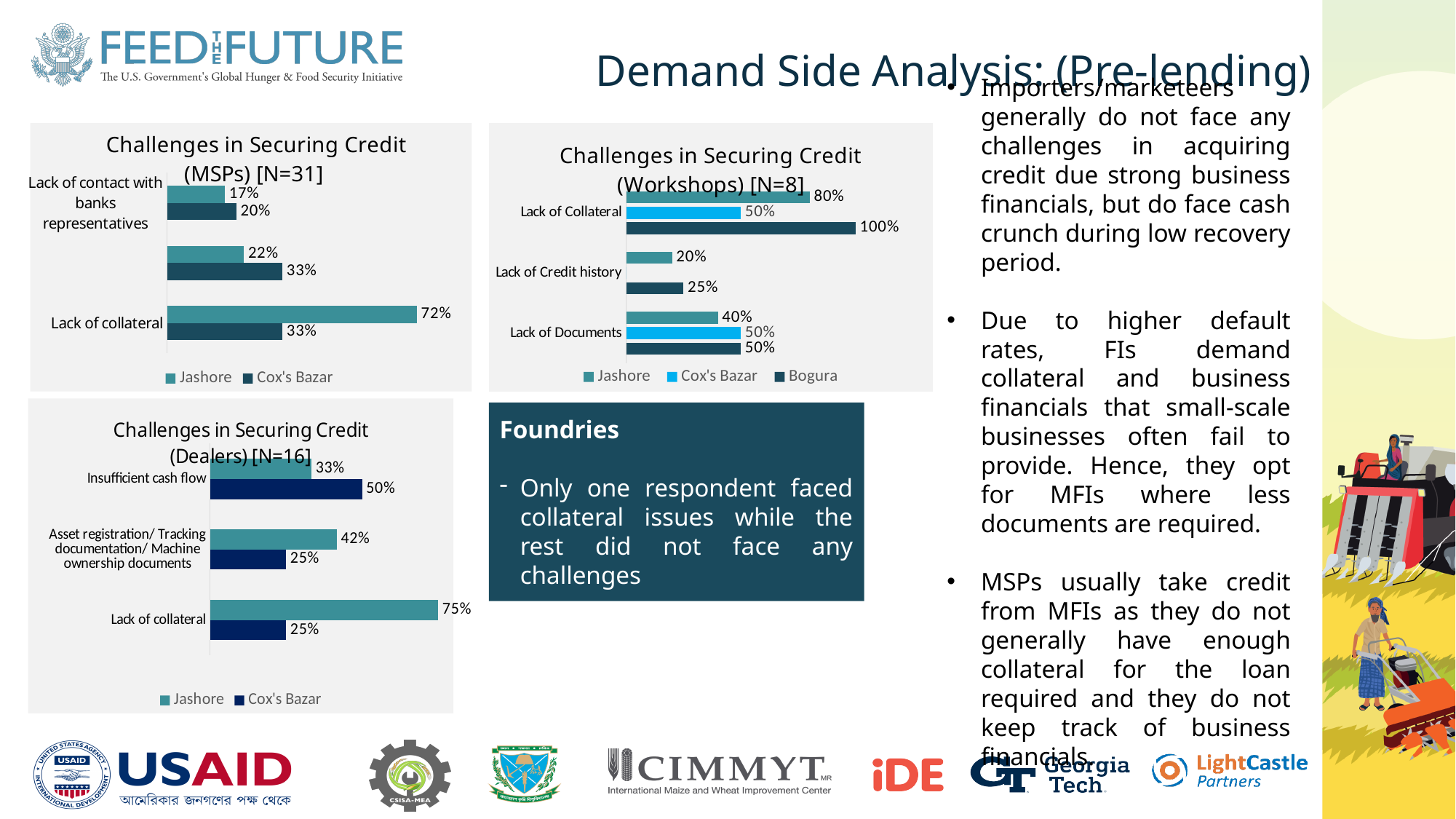
What kind of chart is 'Challenges in Securing Credit (Dealers) [N=16]'? Bar chart In the 'Challenges in Securing Credit (MSPs) [N=31]' chart, what is the difference between the Jashore and Cox's Bazar values for Lack of collateral? 39% In the 'Challenges in Securing Credit (Workshops) [N=8]' chart, what is the value for Jashore for Lack of Credit history? 20% In the 'Challenges in Securing Credit (Dealers) [N=16]' chart, what is the difference between the Jashore and Cox's Bazar values for Asset registration/ Tracking documentation/ Machine ownership documents? 17% In the 'Challenges in Securing Credit (Workshops) [N=8]' chart, how many series does the legend list? 3 In the 'Challenges in Securing Credit (Dealers) [N=16]' chart, how many categories are shown? 3 In the 'Challenges in Securing Credit (Dealers) [N=16]' chart, what is the value for Jashore for Lack of collateral? 75% In the 'Challenges in Securing Credit (Workshops) [N=8]' chart, which series has the highest value for Lack of Collateral? Bogura In the 'Challenges in Securing Credit (Workshops) [N=8]' chart, what is the value for Bogura for Lack of Collateral? 100% In the 'Challenges in Securing Credit (MSPs) [N=31]' chart, what is the value for Cox's Bazar for Lack of contact with banks representatives? 20% In the 'Challenges in Securing Credit (Dealers) [N=16]' chart, which is larger for Insufficient cash flow: Jashore or Cox's Bazar? Cox's Bazar In the 'Challenges in Securing Credit (MSPs) [N=31]' chart, what is the value for Jashore for Lack of collateral? 72%